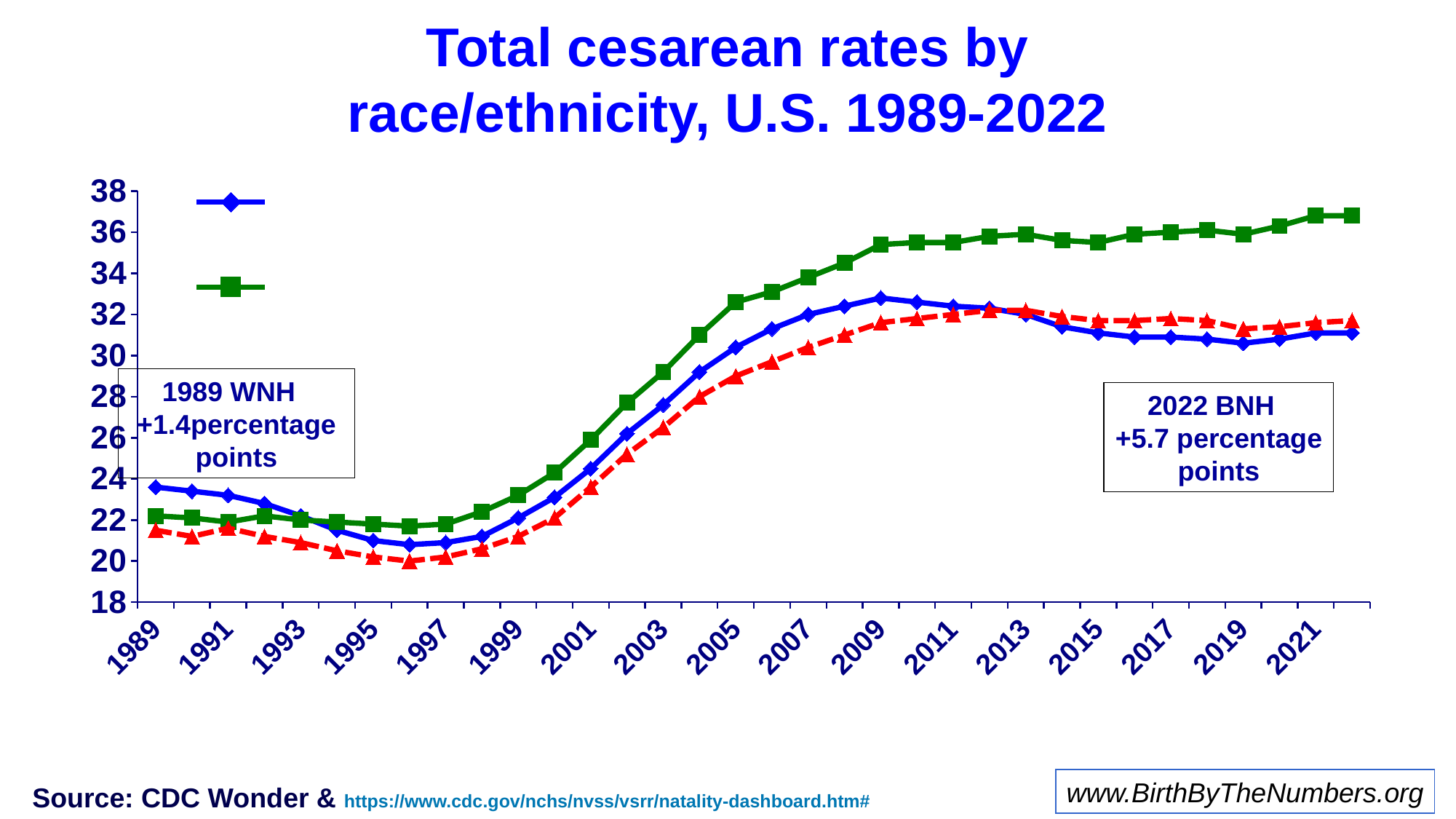
What is the title of the chart? Total cesarean rates by race/ethnicity, U.S. 1989-2022 Does the blue diamond line rise or fall between 1997 and 2009? rise Which line has the highest value in 2022? the green square line Is the value of the blue diamond line in 1989 greater or less than 22? greater How many year labels are shown along the x axis? 17 Is the value of the green square line in 2022 greater or less than 36? greater How many lines are plotted on the chart? 3 Is the value of the green square line in 2009 greater or less than 34? greater Which line has the lowest value in 1996? the red dashed triangle line In 2005, which is higher: the green square line or the blue diamond line? the green square line What kind of chart is shown on the slide? line chart